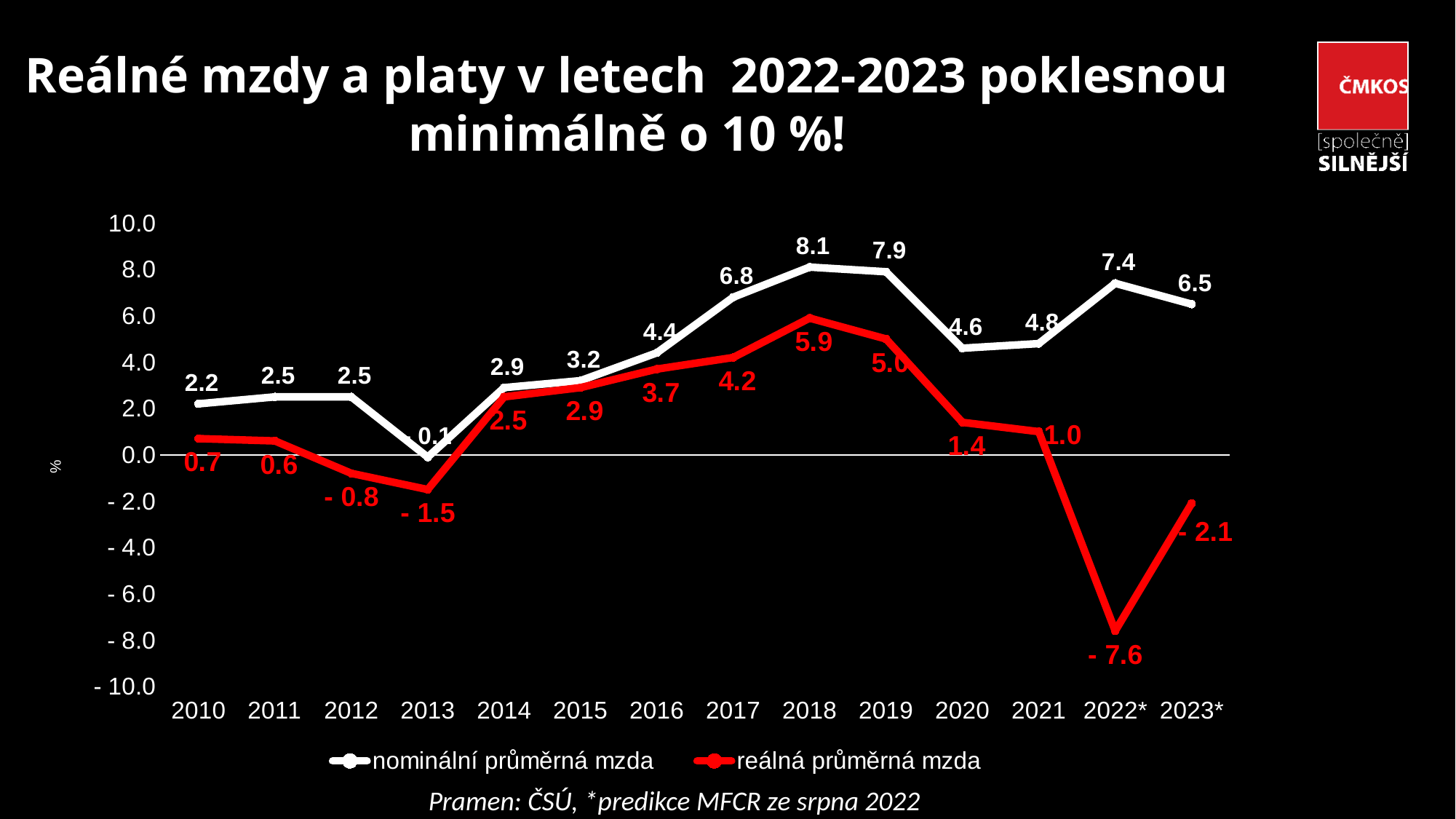
What is the value of reálná průměrná mzda in 2013? - 1.5 In which year is reálná průměrná mzda lowest? 2022* What type of chart is shown on the slide? line chart What is the value of nominální průměrná mzda in 2018? 8.1 Which is larger in 2017: nominální průměrná mzda or reálná průměrná mzda? nominální průměrná mzda In which year is nominální průměrná mzda highest? 2018 What colour is the line for reálná průměrná mzda? red What is the difference between nominální průměrná mzda and reálná průměrná mzda in 2022*? 15.0 Does reálná průměrná mzda rise or fall from 2018 to 2022*? fall What is the value of reálná průměrná mzda in 2022*? - 7.6 How many series does the legend list? 2 How many years are shown on the x axis? 14